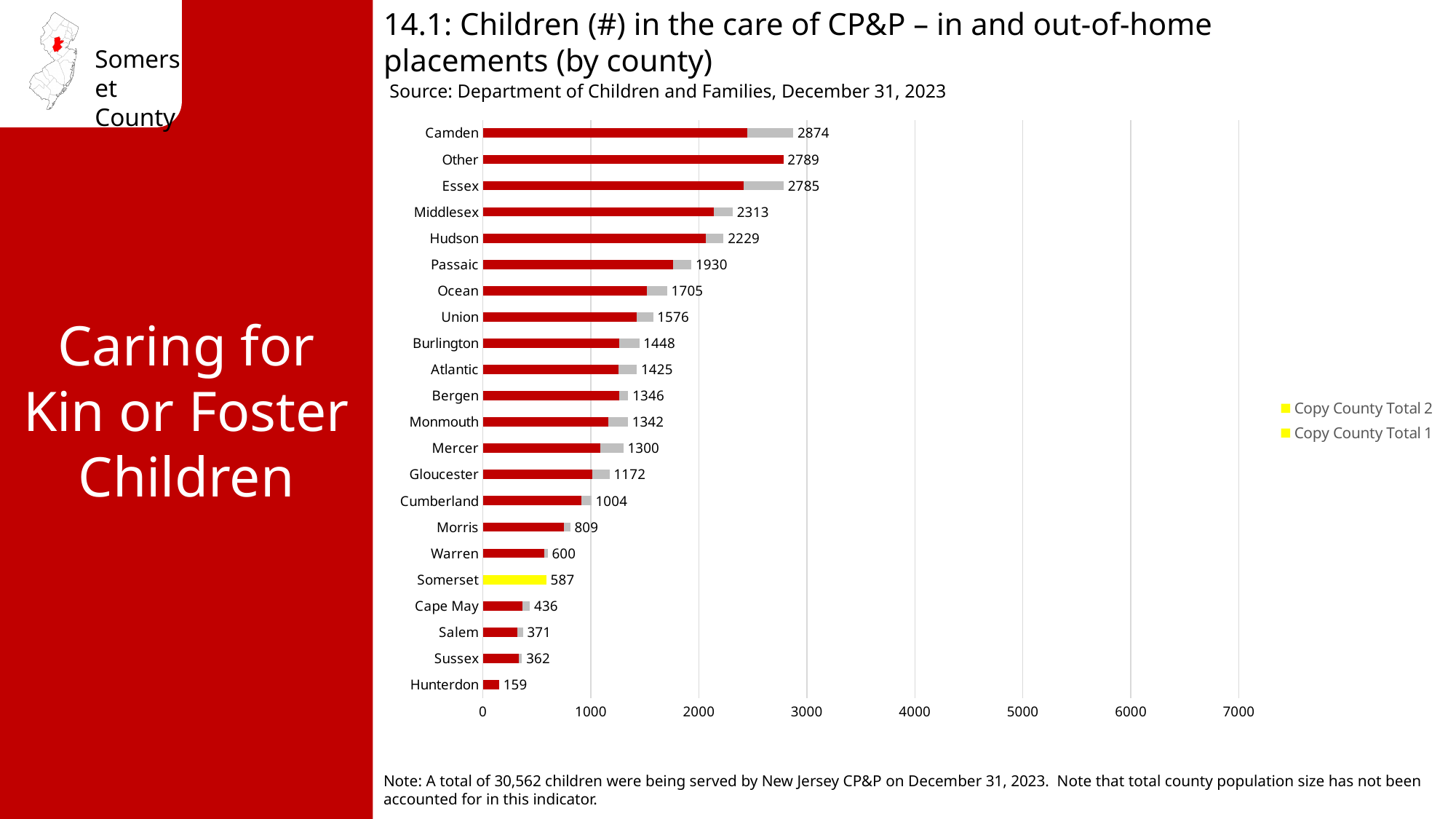
Which has a larger labelled value, Passaic or Ocean? Passaic What is the total number of children in the care of CP&P shown for Somerset? 587 What value is labelled for Camden? 2874 What value is labelled for Hunterdon? 159 What is the difference between the labelled values for Essex and Middlesex? 472 What is the difference between the labelled values for Camden and Hunterdon? 2715 How many series does the legend list? 2 Which county has the highest labelled value on the chart? Camden What kind of chart is shown on the slide? Bar chart How many counties (categories) are listed on the chart? 22 Which has a larger labelled value, Warren or Somerset? Warren Which county has the lowest labelled value on the chart? Hunterdon